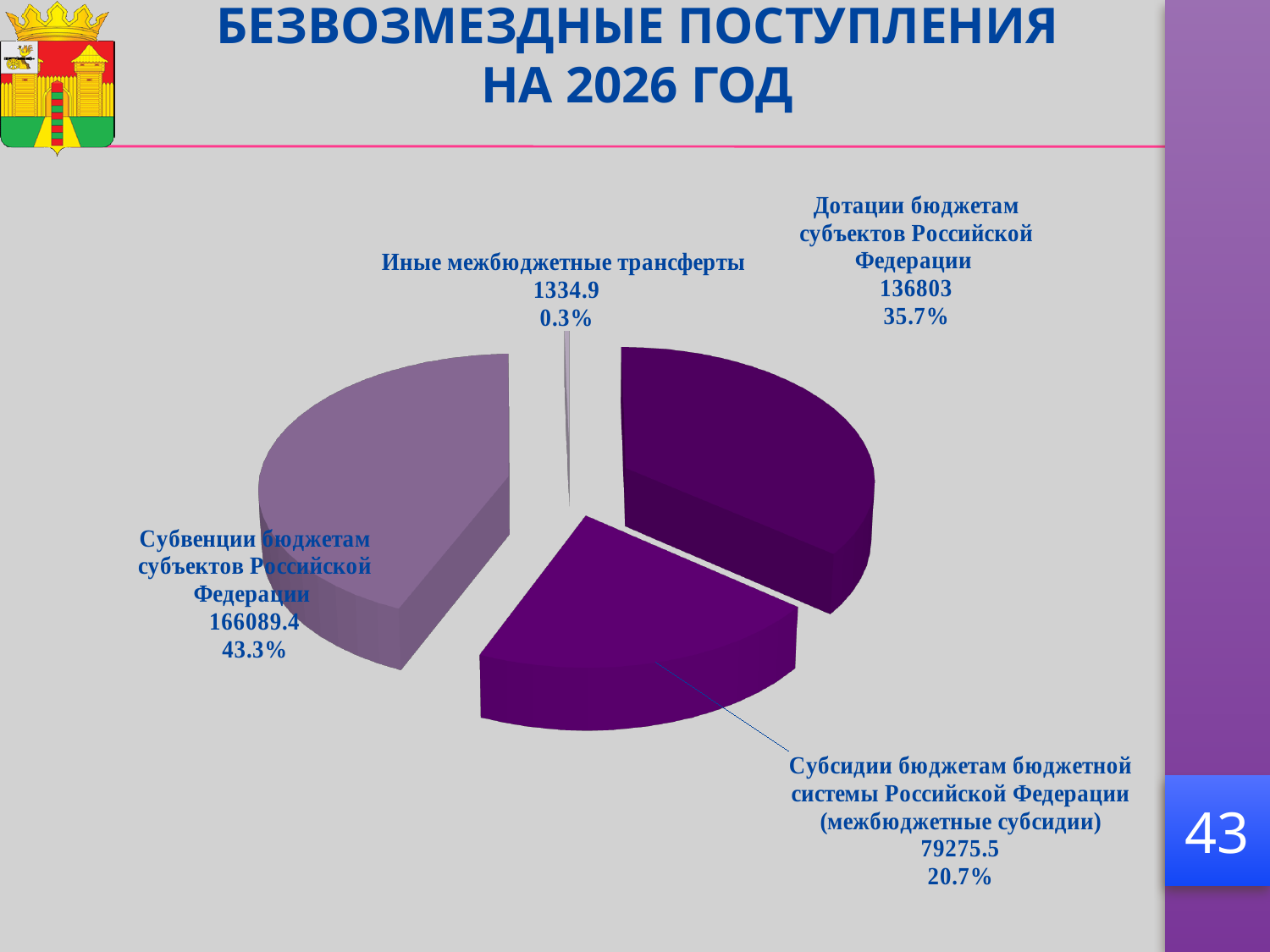
What is the value for Субвенции бюджетам субъектов Российской Федерации? 166089.4 Which category has the largest value? Субвенции бюджетам субъектов Российской Федерации How many slices does the pie chart have? 4 What is the title of the slide containing the chart? БЕЗВОЗМЕЗДНЫЕ ПОСТУПЛЕНИЯ НА 2026 ГОД What share of the pie does Субсидии бюджетам бюджетной системы Российской Федерации (межбюджетные субсидии) represent? 20.7% What is the value for Дотации бюджетам субъектов Российской Федерации? 136803 What is the value for Иные межбюджетные трансферты? 1334.9 Which is larger: Дотации бюджетам субъектов Российской Федерации or Субсидии бюджетам бюджетной системы Российской Федерации (межбюджетные субсидии)? Дотации бюджетам субъектов Российской Федерации What share of the pie does Дотации бюджетам субъектов Российской Федерации represent? 35.7% What is the difference between the values for Субвенции бюджетам субъектов Российской Федерации and Дотации бюджетам субъектов Российской Федерации? 29286.4 Which category has the smallest value? Иные межбюджетные трансферты What type of chart is shown on the slide? Pie chart